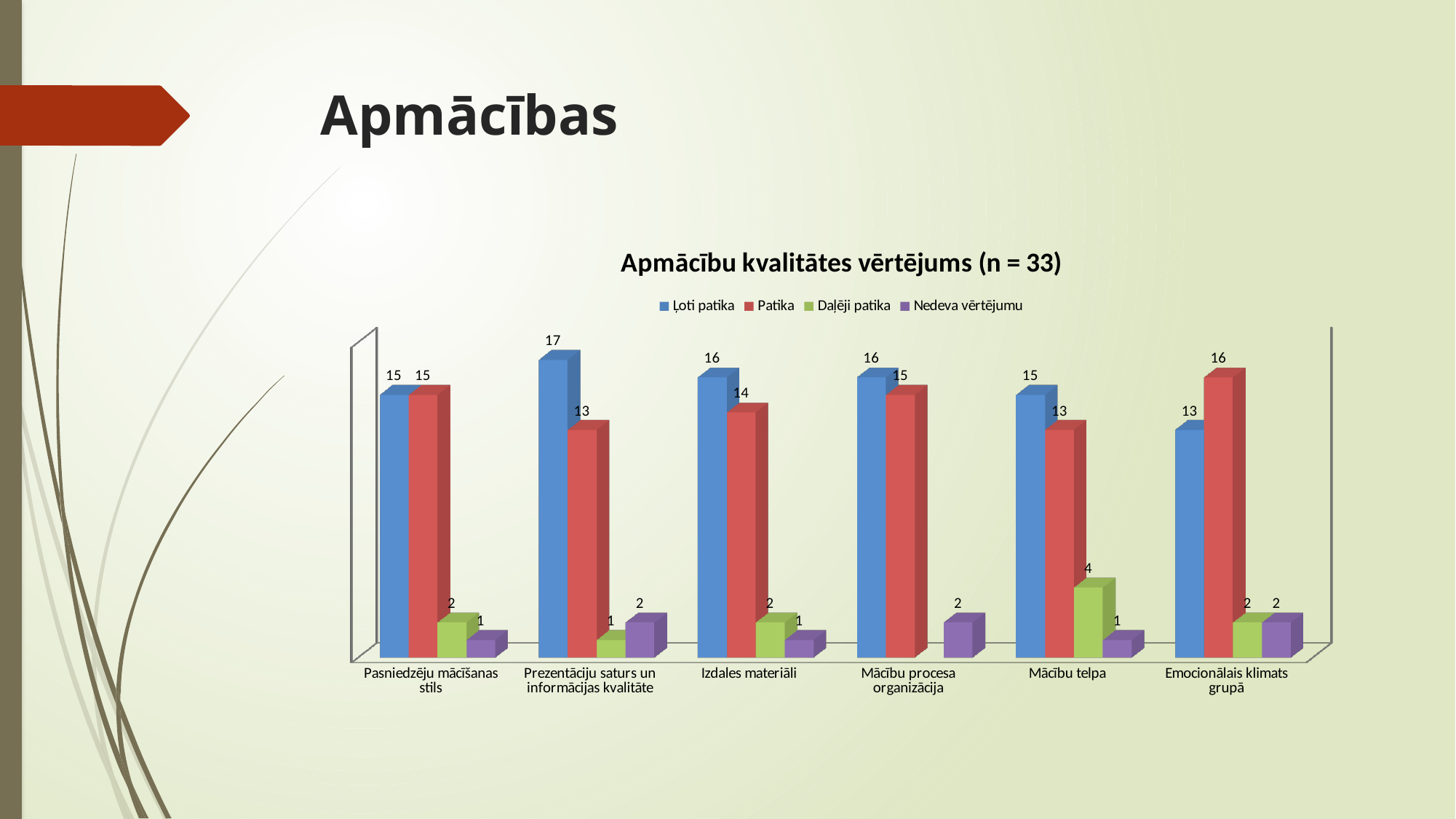
How many series does the legend list? 4 What is the difference between "Ļoti patika" and "Patika" for "Prezentāciju saturs un informācijas kvalitāte"? 4 How many categories are shown on the x axis? 6 What is the title of the chart? Apmācību kvalitātes vērtējums (n = 33) What is the value of "Patika" for "Emocionālais klimats grupā"? 16 What is the value of "Daļēji patika" for "Mācību telpa"? 4 What is the value of "Nedeva vērtējumu" for "Mācību procesa organizācija"? 2 What is the value of "Ļoti patika" for "Prezentāciju saturs un informācijas kvalitāte"? 17 For "Emocionālais klimats grupā", which is larger: "Ļoti patika" or "Patika"? Patika Which category has the lowest "Patika" value? Prezentāciju saturs un informācijas kvalitāte and Mācību telpa (both 13) Which category has the highest "Ļoti patika" value? Prezentāciju saturs un informācijas kvalitāte What kind of chart is shown on the slide? Bar chart